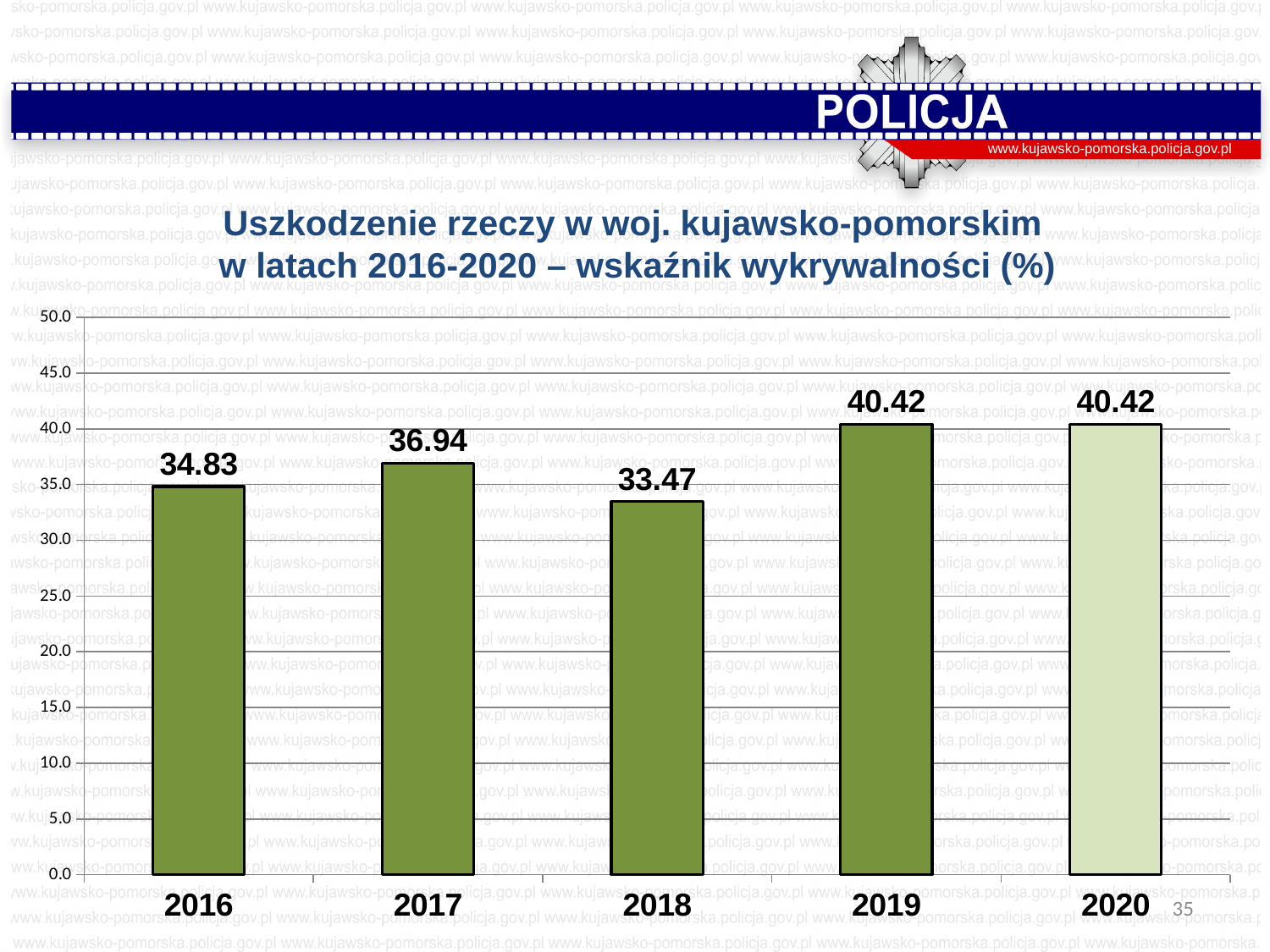
What is the value shown for 2020? 40.42 How many years are shown on the x axis? 5 What is the difference between the values for 2017 and 2016? 2.11 What kind of chart is shown on the slide? bar chart Does the value rise or fall from 2018 to 2019? rise What is the value shown for 2018? 33.47 Which is larger, the value for 2017 or the value for 2018? 2017 What is the detection rate value for 2016? 34.83 Which year has the lowest value? 2018 What is the difference between the values for 2019 and 2018? 6.95 Is the value for 2019 greater or less than 40.0? greater What is the title of the chart? Uszkodzenie rzeczy w woj. kujawsko-pomorskim w latach 2016-2020 – wskaźnik wykrywalności (%)